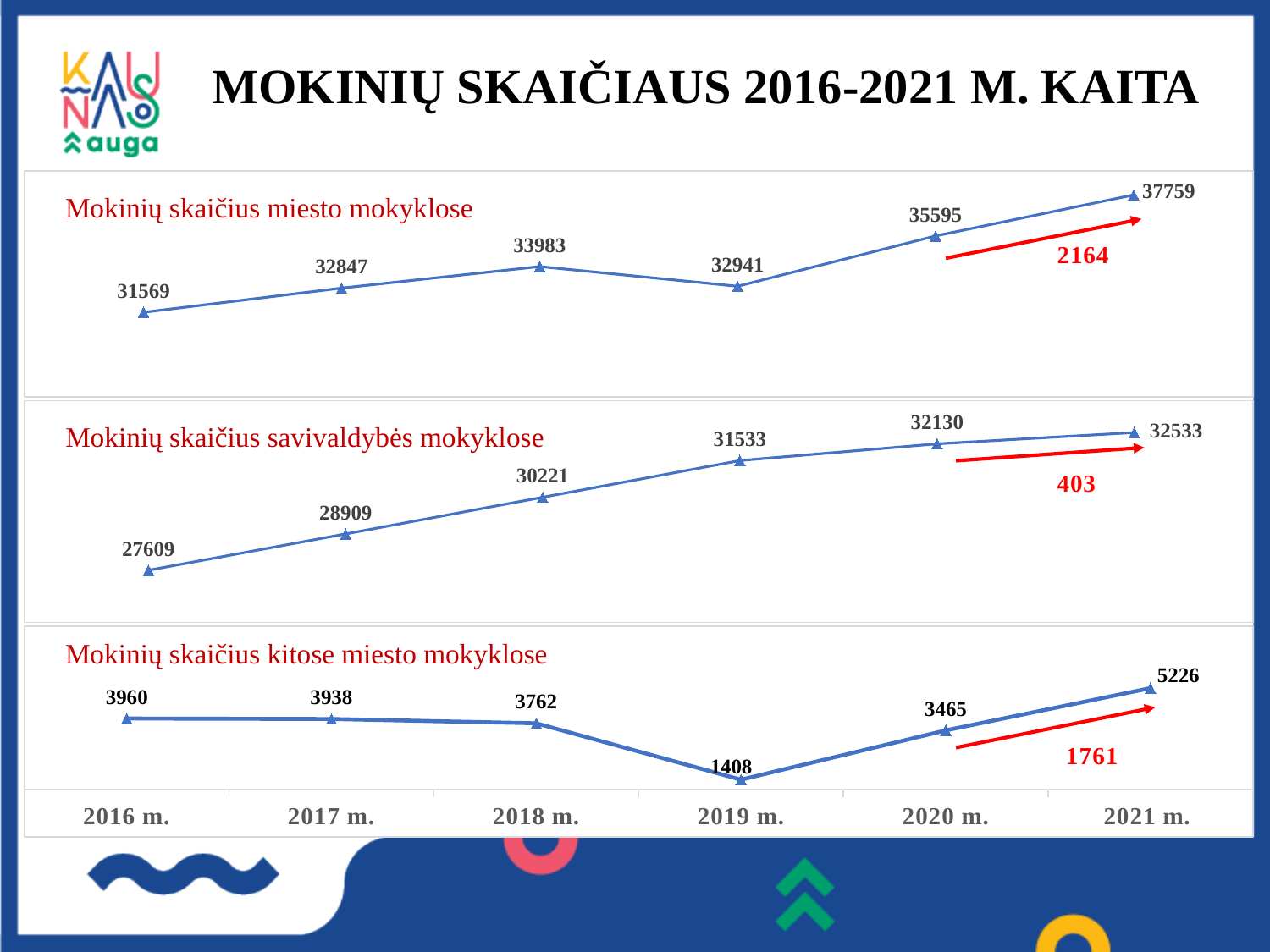
In the chart 'Mokinių skaičius savivaldybės mokyklose', which year has the lowest value? 2016 m. In the chart 'Mokinių skaičius miesto mokyklose', what is the value for 2016 m.? 31569 How many years are plotted in the chart 'Mokinių skaičius miesto mokyklose'? 6 In the chart 'Mokinių skaičius miesto mokyklose', what is the difference between the 2021 m. and 2020 m. values? 2164 In the chart 'Mokinių skaičius miesto mokyklose', which year has the highest value? 2021 m. In the chart 'Mokinių skaičius kitose miesto mokyklose', what is the value for 2019 m.? 1408 In the chart 'Mokinių skaičius kitose miesto mokyklose', what is the difference between the 2021 m. and 2020 m. values? 1761 What kind of chart is 'Mokinių skaičius savivaldybės mokyklose'? line chart In the chart 'Mokinių skaičius savivaldybės mokyklose', do the values rise or fall from 2016 m. to 2021 m.? rise In the chart 'Mokinių skaičius kitose miesto mokyklose', which year has the lowest value? 2019 m. In the chart 'Mokinių skaičius kitose miesto mokyklose', which is larger, the value for 2016 m. or 2020 m.? 2016 m. In the chart 'Mokinių skaičius savivaldybės mokyklose', what is the value for 2018 m.? 30221